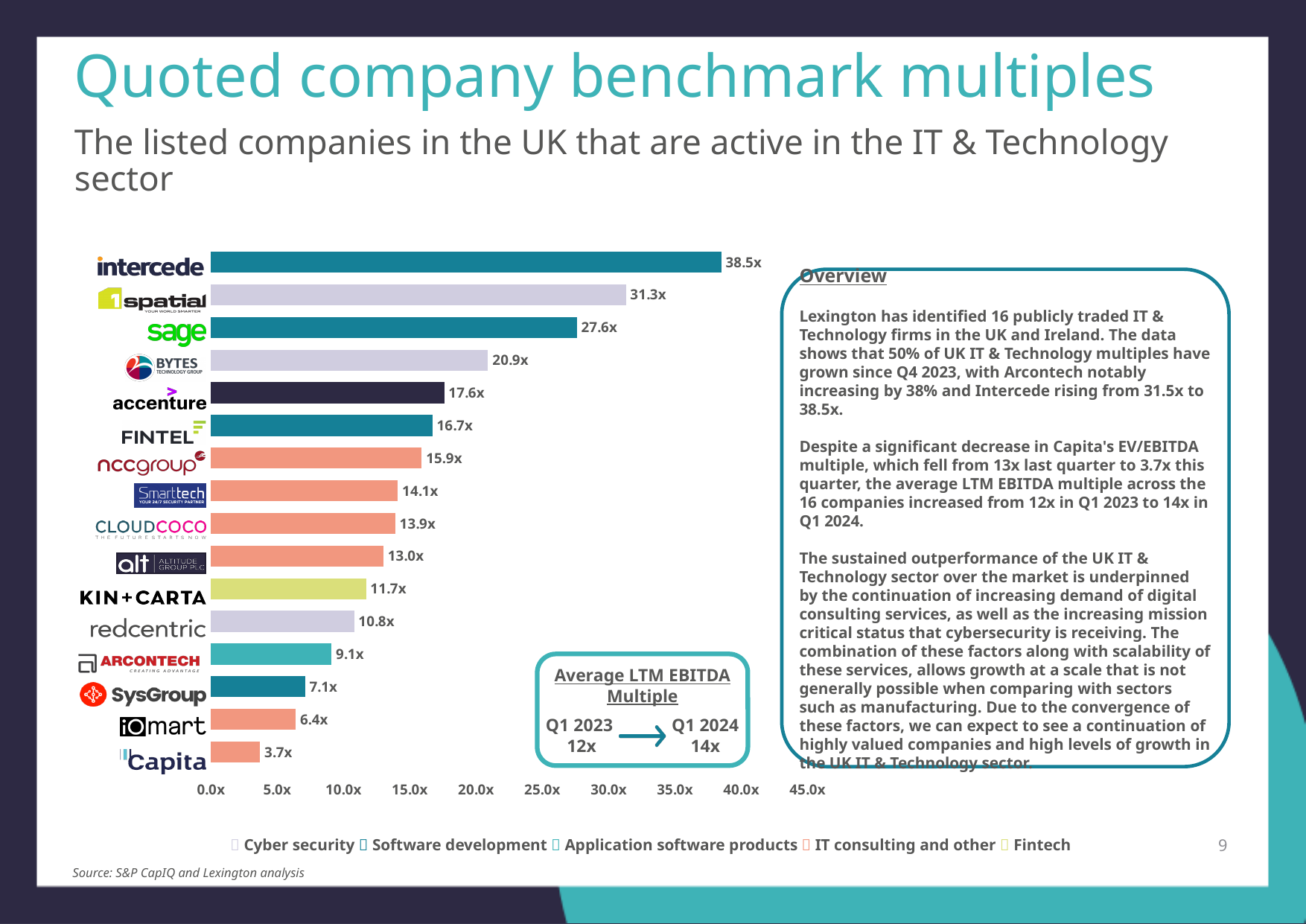
How many sector categories does the legend at the bottom of the chart list? 5 Which company has the lowest multiple on the chart? Capita What is the multiple shown for Capita? 3.7x What is the multiple shown for Arcontech? 9.1x What is the multiple shown for Sage? 27.6x What is the difference between the multiples for Intercede and 1Spatial? 7.2x What kind of chart is shown on the slide? Bar chart How many companies are shown on the chart? 16 What is the multiple shown for Intercede? 38.5x Which company has the highest multiple on the chart? Intercede Which has a larger multiple, Accenture or Fintel? Accenture What is the difference between the multiples for Kin+Carta and Redcentric? 0.9x